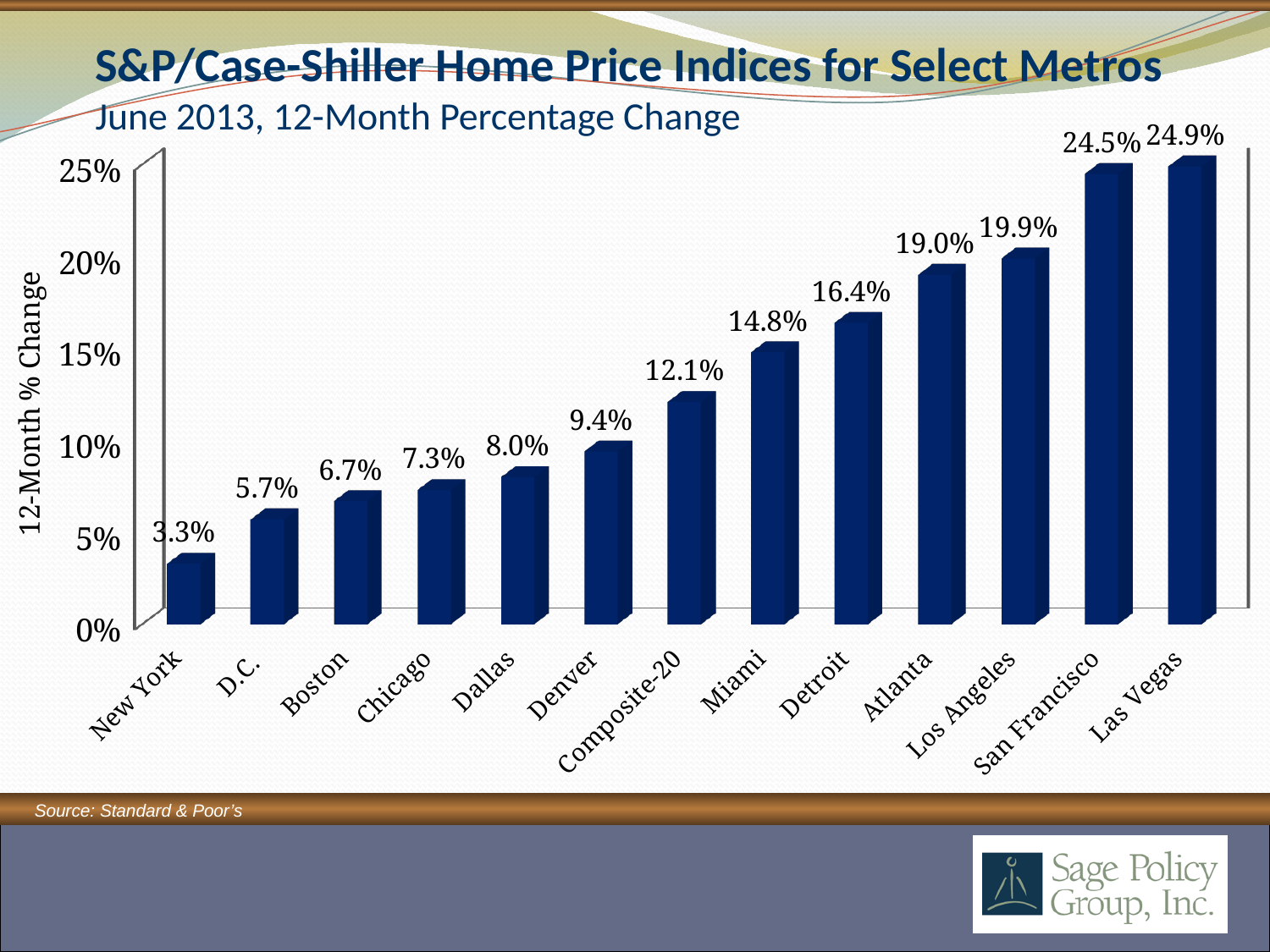
How many metros are shown on the chart? 13 Which has a larger 12-month percentage change, Atlanta or Dallas? Atlanta What is the 12-month percentage change for Miami? 14.8% What is the 12-month percentage change for Chicago? 7.3% What is the difference between the values for Las Vegas and New York? 21.6% Which metro has the lowest 12-month percentage change? New York Which metro has the highest 12-month percentage change? Las Vegas What kind of chart is shown on the slide? Bar chart What is the 12-month percentage change for Composite-20? 12.1% Is the value for Los Angeles greater or less than 15%? greater What is the difference between the values for Detroit and Denver? 7.0% Do the values rise or fall from left to right along the x axis? Rise